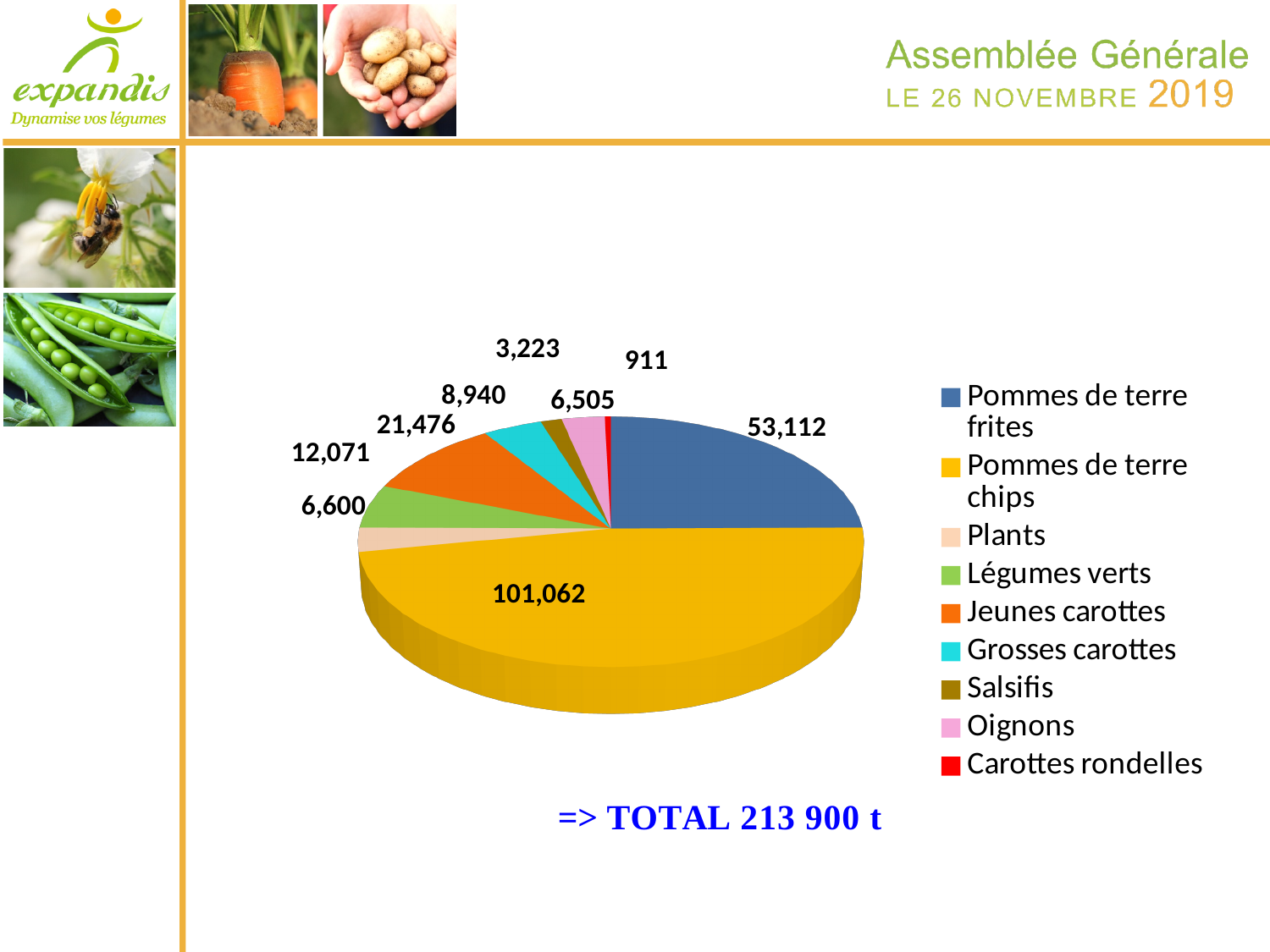
What is the difference between the values for Pommes de terre chips and Pommes de terre frites? 47,950 What is the value for Pommes de terre frites? 53,112 Which category has the largest slice of the pie? Pommes de terre chips Which category has the smallest slice of the pie? Carottes rondelles What type of chart is shown on the slide? Pie chart What total is stated below the pie chart? 213 900 t What is the value for Salsifis? 3,223 Which is larger, the value for Légumes verts or the value for Grosses carottes? Légumes verts What is the value for Carottes rondelles? 911 How many categories does the pie chart's legend list? 9 What is the value for Jeunes carottes? 21,476 What is the value for Pommes de terre chips? 101,062